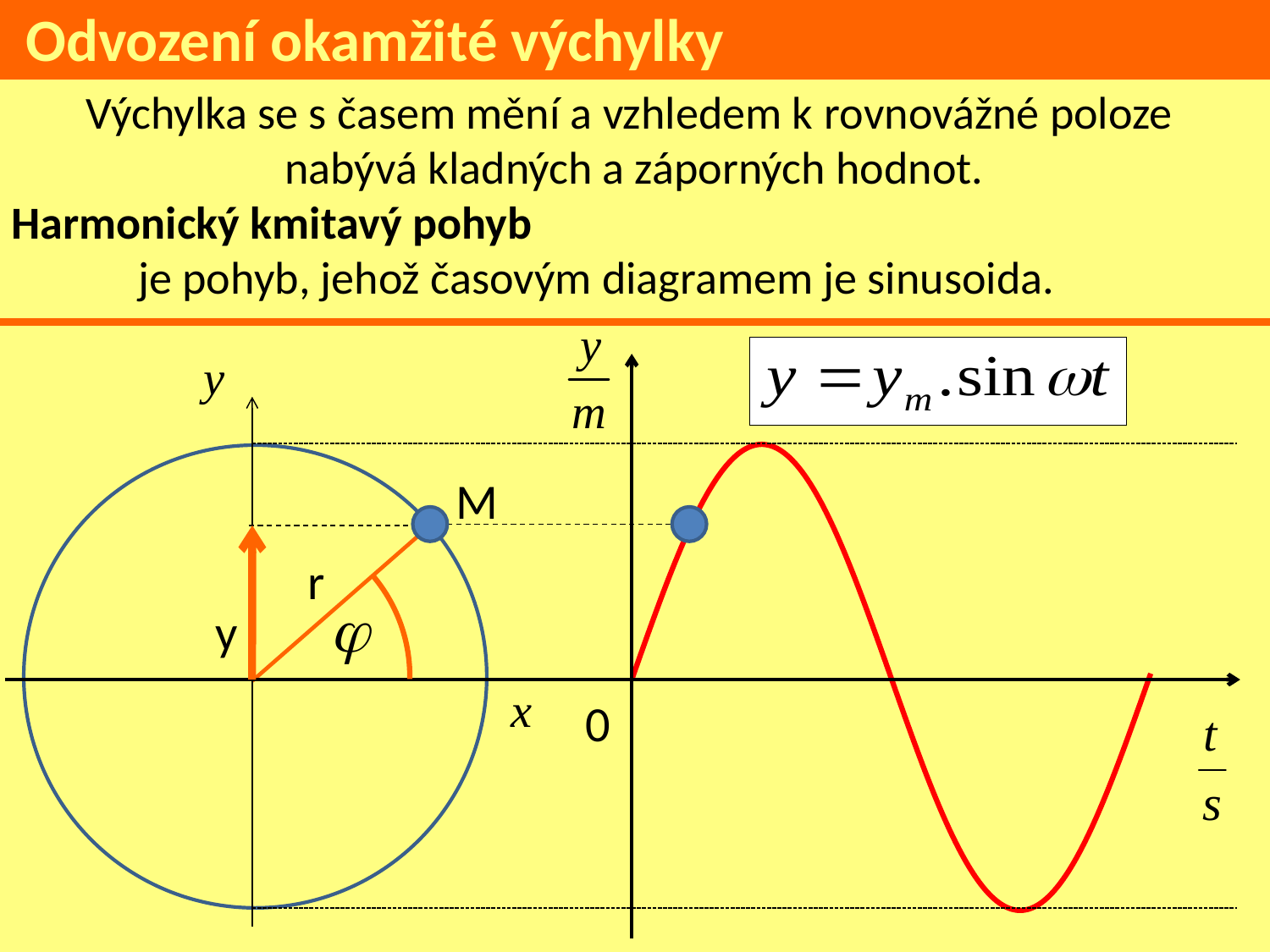
Does the red curve rise or fall immediately after the origin 0? rise Does the red curve rise or fall between its first peak and its trough? fall What is the label on the horizontal axis of the right-hand graph? t/s What is the value of y where the red curve starts at the origin? 0 What kind of chart is shown on the right side of the slide? line chart What equation is shown in the box above the graph? y = y_m . sin ωt